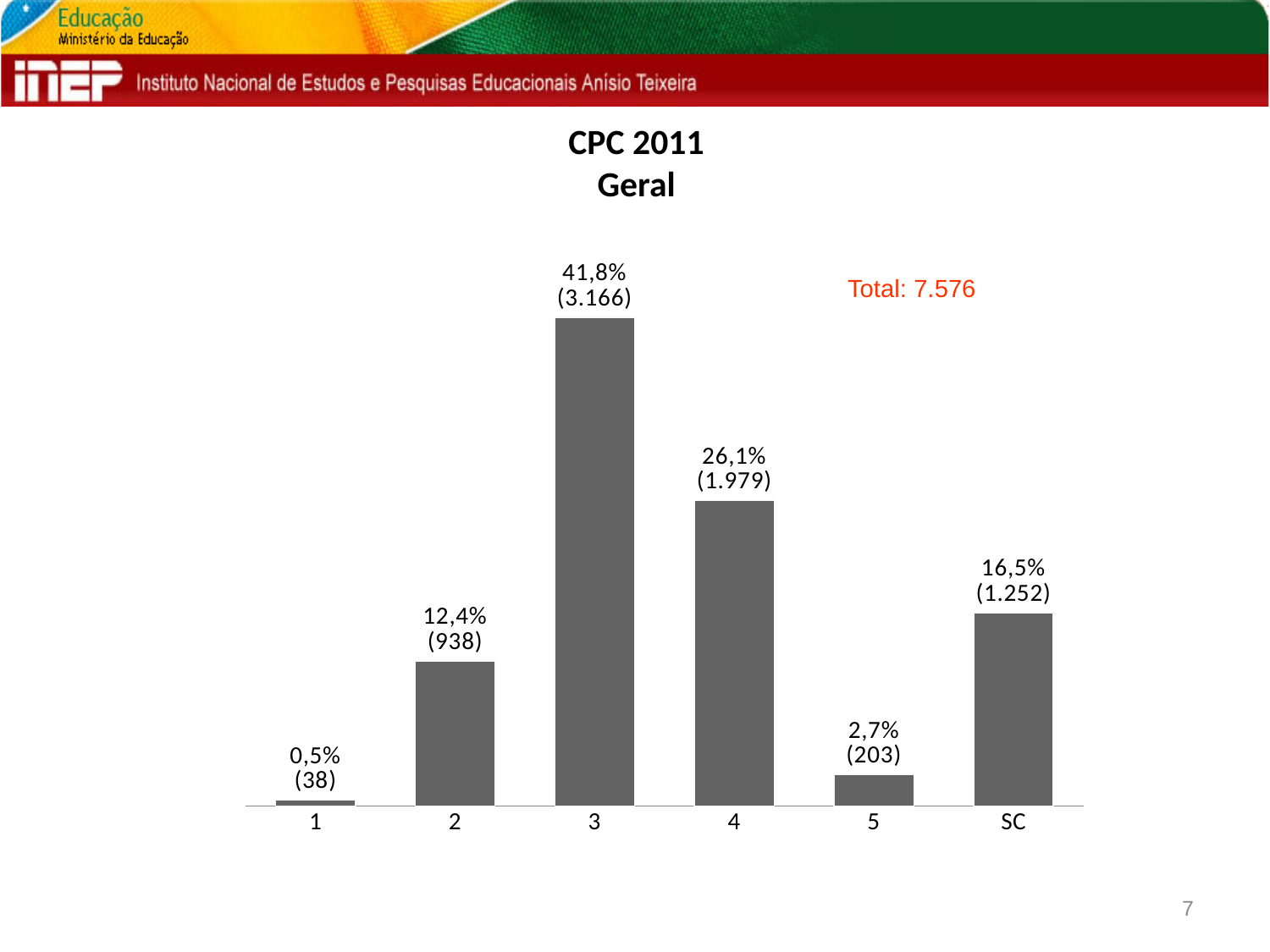
What count is shown in parentheses for category 4? 1.979 What is the difference in percentage points between category 3 and category 4? 15,7 Which category has the highest value? 3 What is the title of the chart? CPC 2011 Geral How many categories are shown on the x axis? 6 Which is larger, the value for category 2 or the value for SC? SC What kind of chart is shown on the slide? bar chart What percentage is shown for the SC category? 16,5% What total is stated on the slide? 7.576 What percentage is shown for category 3? 41,8% Which category has the lowest value? 1 What count is shown in parentheses for category 2? 938